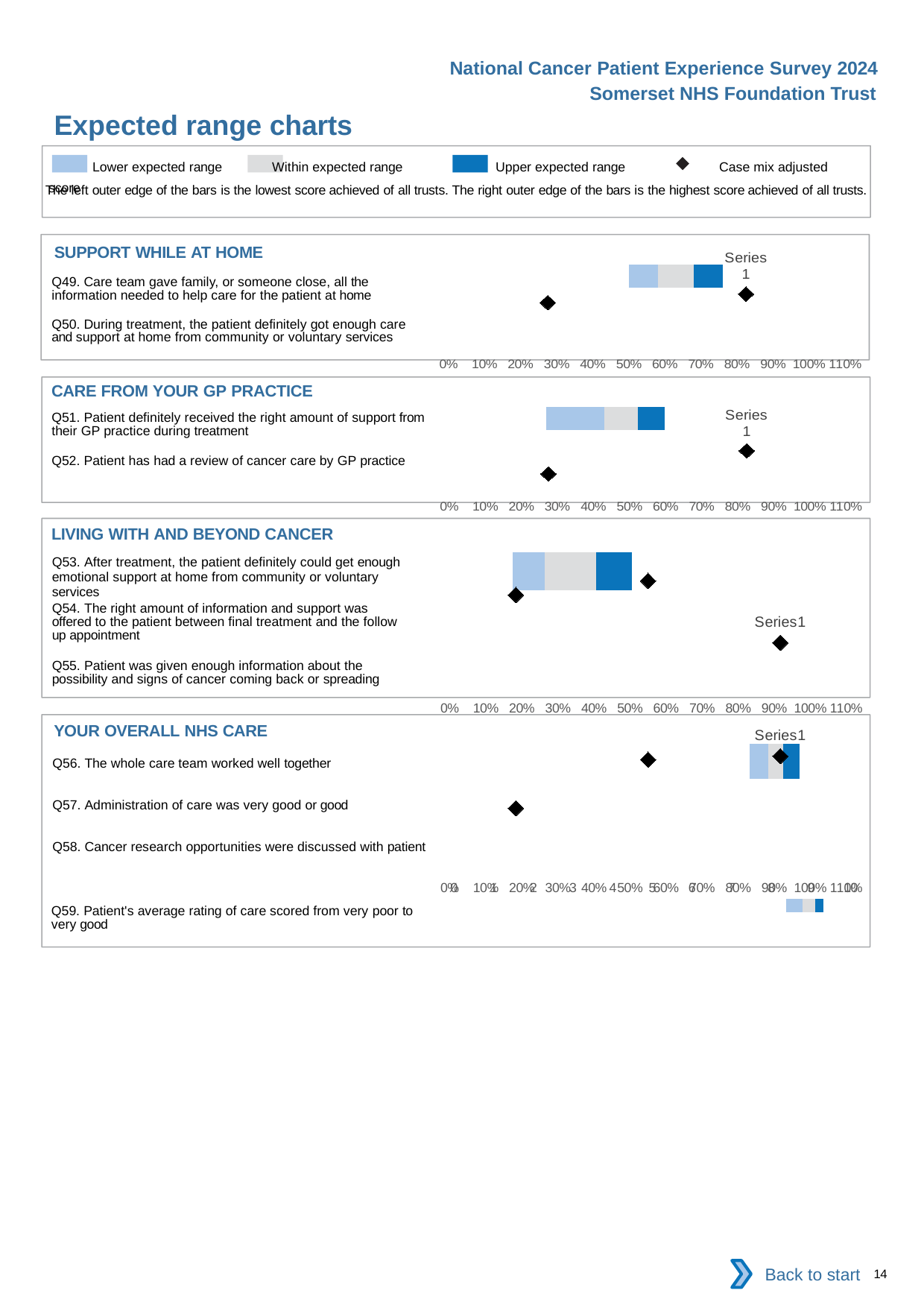
How many entries does the legend at the top of the slide list? 4 How many diamond markers are plotted in the LIVING WITH AND BEYOND CANCER chart? 3 In the CARE FROM YOUR GP PRACTICE chart, is the right edge of the expected range bar greater or less than 70%? less How many questions are listed in the YOUR OVERALL NHS CARE section? 4 In the CARE FROM YOUR GP PRACTICE chart, is the left edge of the expected range bar greater or less than 20%? greater In the LIVING WITH AND BEYOND CANCER chart, is the right edge of the expected range bar greater or less than 60%? less How many questions are listed in the SUPPORT WHILE AT HOME section? 2 What is the highest tick shown on the x axis of the CARE FROM YOUR GP PRACTICE chart? 110% What kind of chart is used in the SUPPORT WHILE AT HOME section? bar chart According to the legend, what does the diamond marker represent? Case mix adjusted score